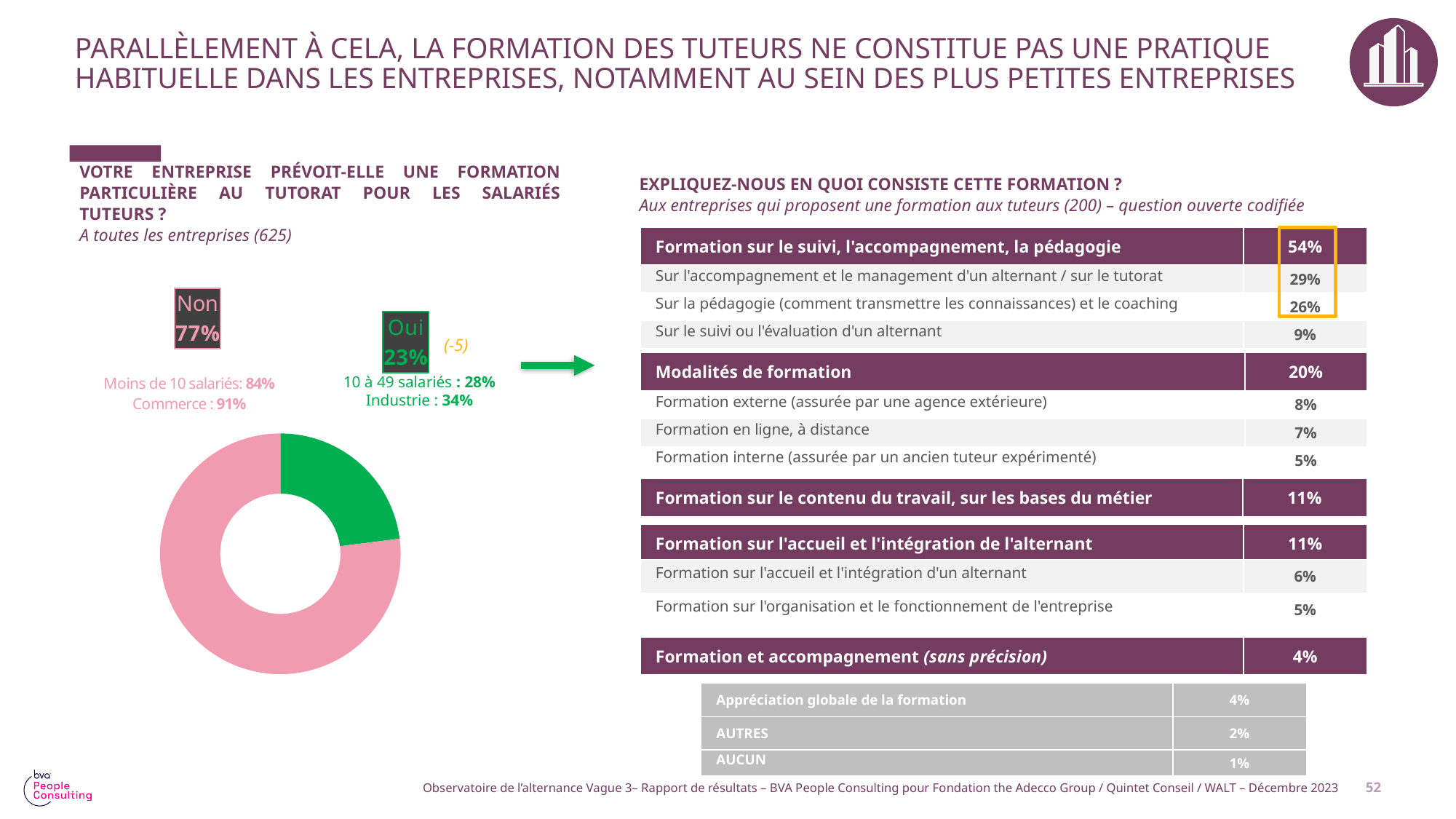
What colour is the "Non" slice in the donut chart? Pink What kind of chart is shown on the left of the slide? Pie (donut) chart What is the difference between the "Non" and "Oui" values in the donut chart? 54 percentage points What colour is the "Oui" slice in the donut chart? Green In the donut chart, what is the value for "Non"? 77% Which category has the largest slice in the donut chart? Non What share of the donut chart does the "Oui" slice represent? 23% How many categories does the donut chart show? 2 Which category has the smallest slice in the donut chart? Oui In the donut chart, what is the value for "Oui"? 23% In the donut chart, is the value for "Oui" larger or smaller than the value for "Non"? Smaller